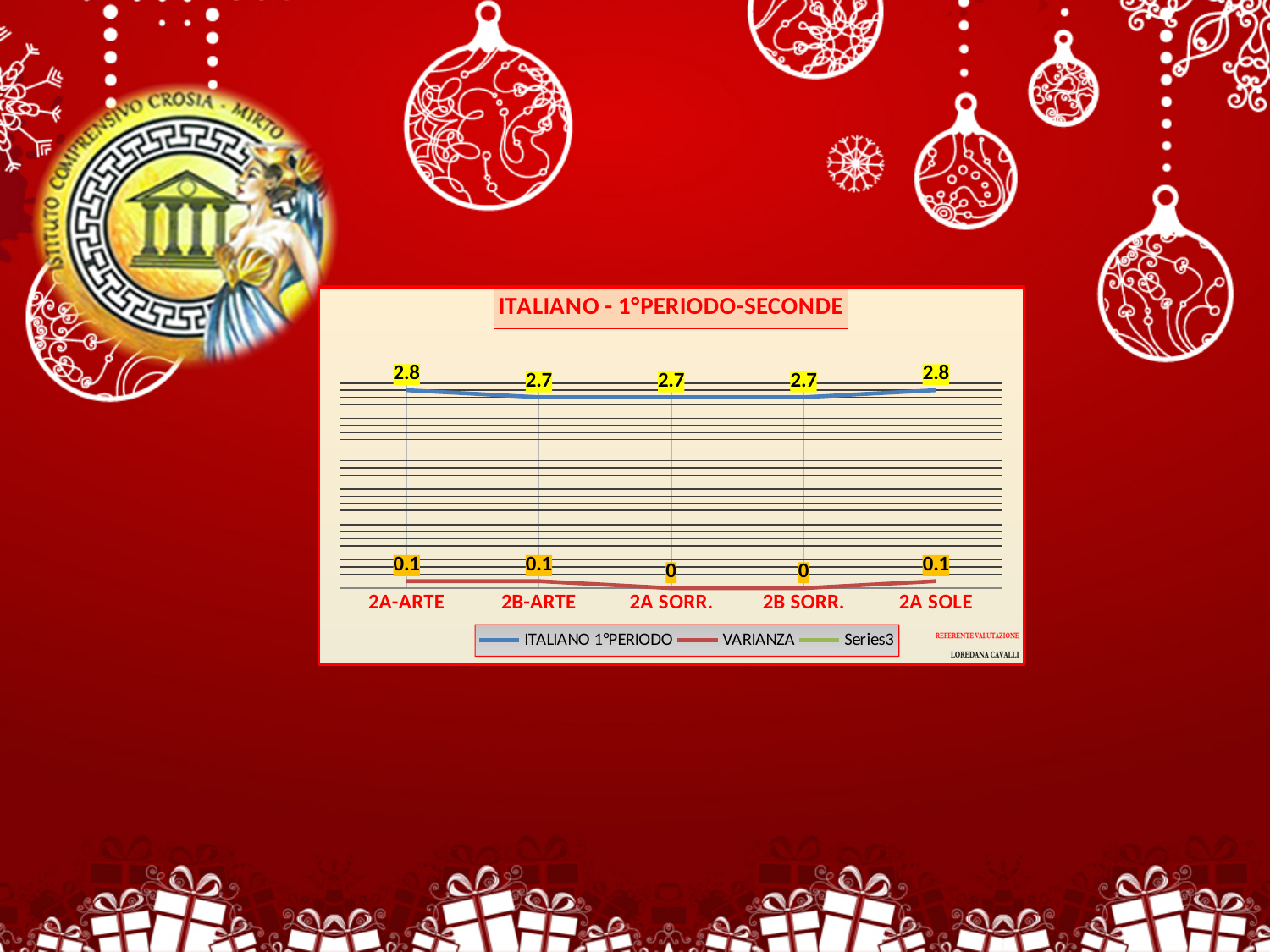
What is the ITALIANO 1°PERIODO value for 2B SORR.? 2.7 What is the difference between the ITALIANO 1°PERIODO values for 2A-ARTE and 2A SORR.? 0.1 What is the ITALIANO 1°PERIODO value for 2B-ARTE? 2.7 What is the ITALIANO 1°PERIODO value for 2A-ARTE? 2.8 How many categories are shown on the x axis? 5 What is the VARIANZA value for 2A SORR.? 0 Is the ITALIANO 1°PERIODO value for 2A SOLE larger or smaller than the value for 2B SORR.? larger What is the VARIANZA value for 2A SOLE? 0.1 Which category has the lowest VARIANZA value, 2B-ARTE or 2B SORR.? 2B SORR. What kind of chart is shown on the slide? line chart What is the title of the chart? ITALIANO - 1°PERIODO-SECONDE How many series does the legend list? 3